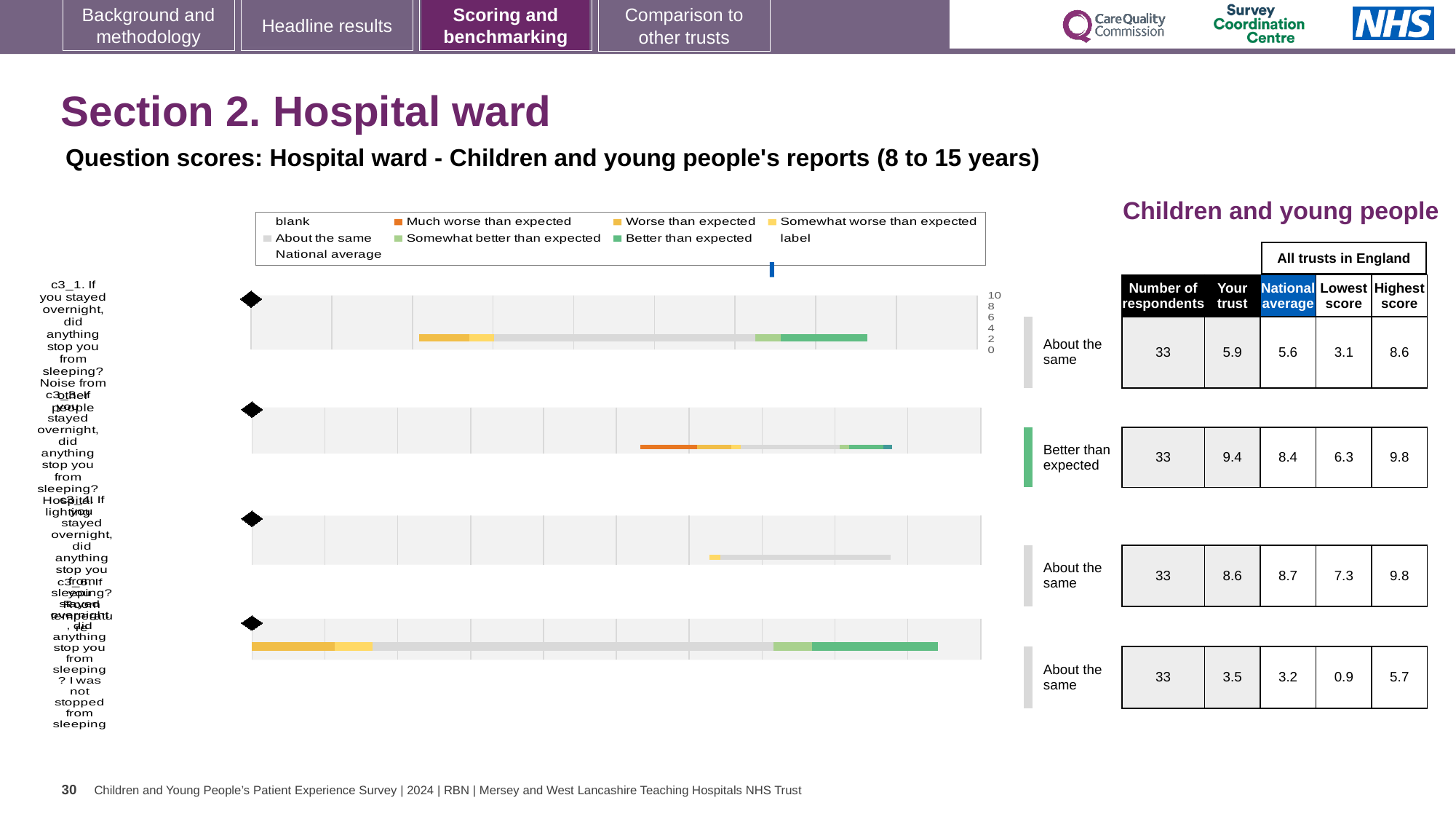
How many respondents are reported for the second chart from the top? 33 How many benchmark bar charts are shown on the slide? 4 What is the highest score across all trusts in England for the third chart from the top? 9.8 What is the lowest score across all trusts in England for the fourth (bottom) chart? 0.9 What is the national average for the second chart from the top? 8.4 What benchmark category label is shown next to the second chart from the top? Better than expected What is the 'Your trust' score for the first (top) chart? 5.9 For the third chart from the top, is the 'Your trust' score or the national average larger? national average Which chart has the highest 'Your trust' score? the second chart from the top (9.4) For the first (top) chart, what is the difference between the 'Your trust' score and the national average? 0.3 What kind of chart is used to show the benchmark results on this slide? bar chart Which chart has the lowest 'Your trust' score? the fourth (bottom) chart (3.5)